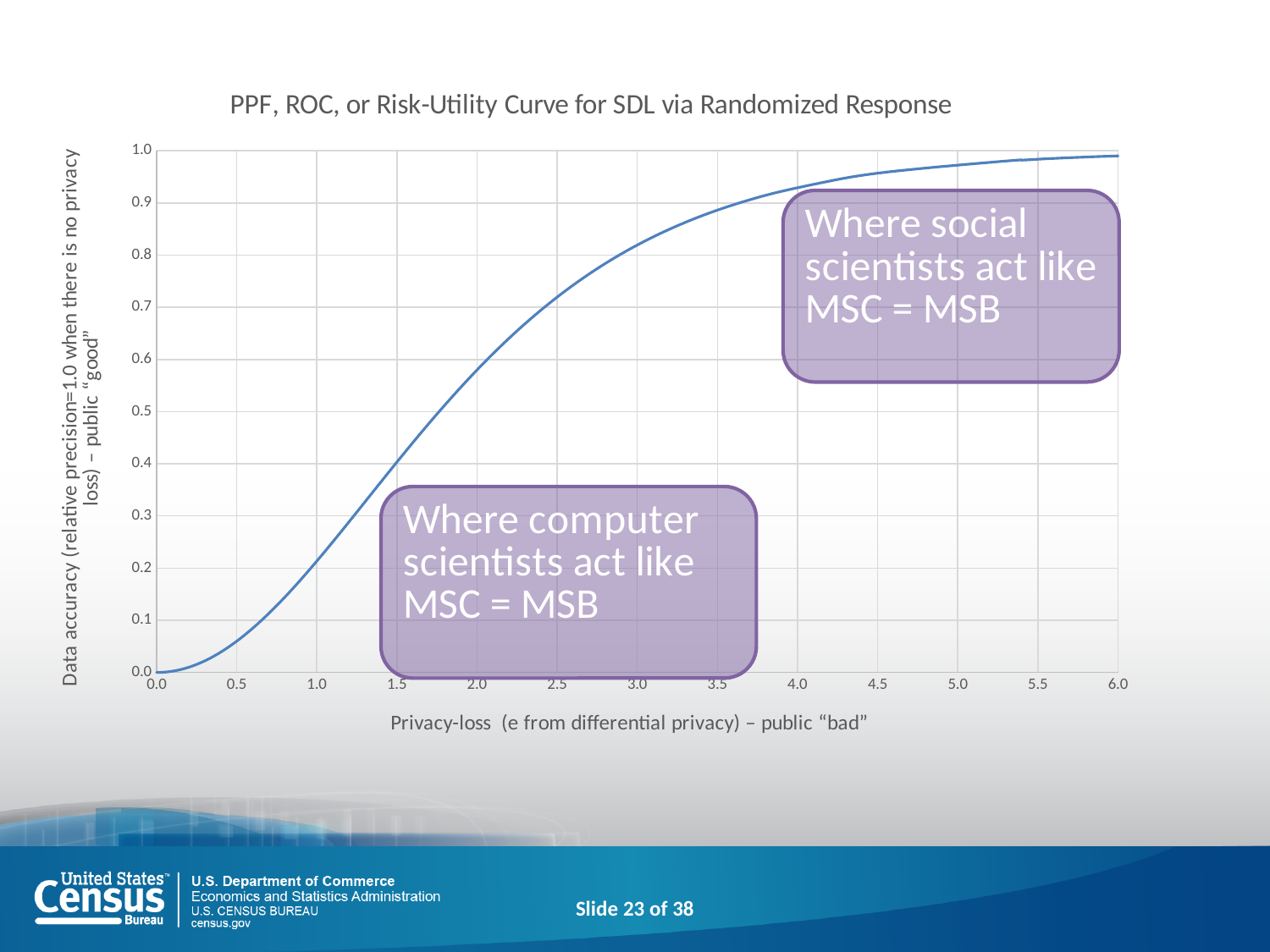
What kind of chart is shown on the slide? line chart Is the data accuracy at a privacy-loss of 5.0 greater or less than 0.9? greater Is the data accuracy at a privacy-loss of 1.0 greater or less than 0.3? less How many lines are plotted on the chart? 1 What is the title of the chart? PPF, ROC, or Risk-Utility Curve for SDL via Randomized Response Is the data accuracy at a privacy-loss of 4.0 greater or less than 0.9? greater What is the highest value shown on the x axis? 6.0 Does the curve rise or fall as privacy-loss increases along the x axis? rise What is the label of the x axis? Privacy-loss (e from differential privacy) – public "bad" Is the data accuracy higher at a privacy-loss of 3.0 or at a privacy-loss of 1.0? 3.0